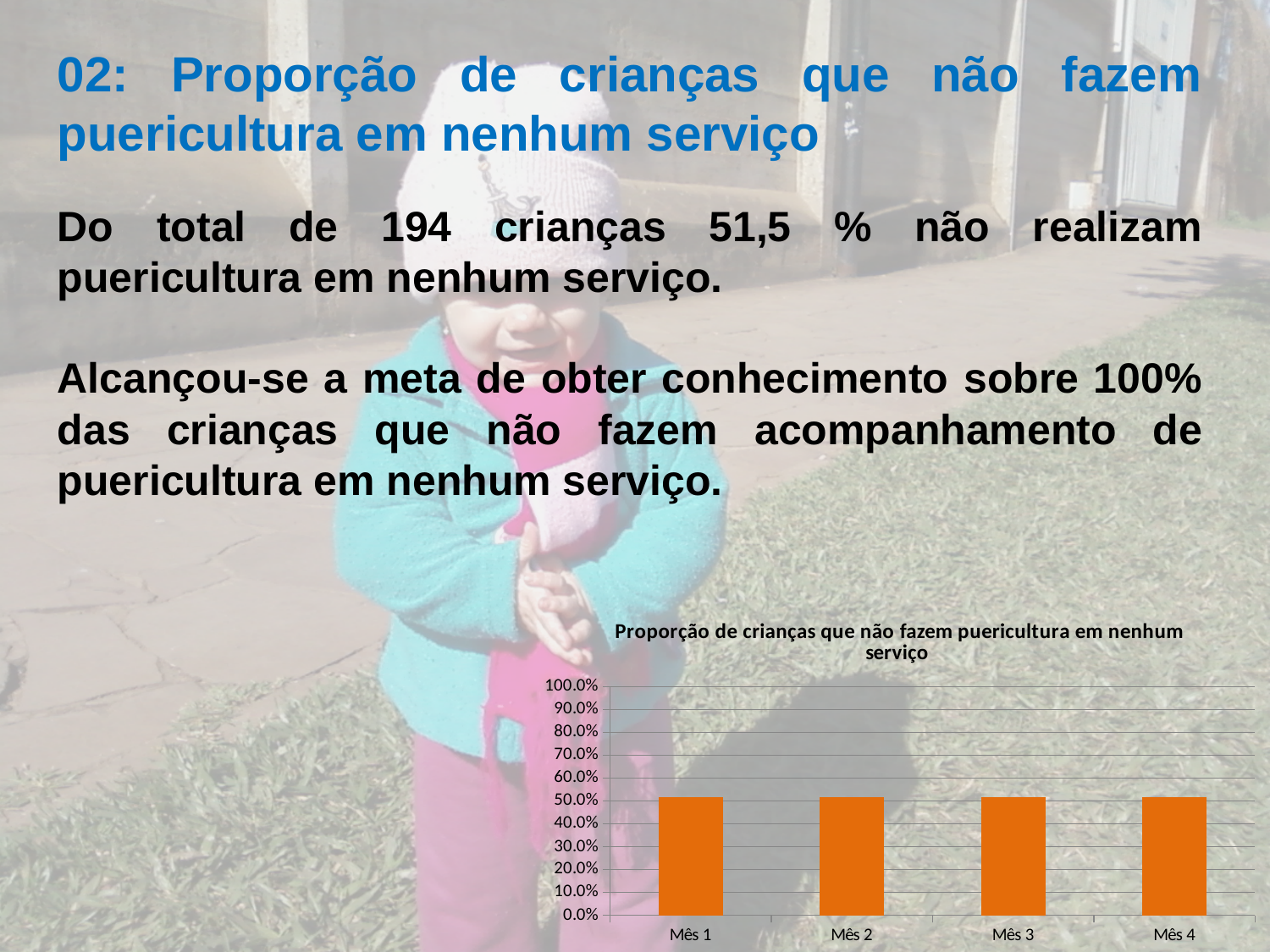
How many categories are shown on the x axis of the chart? 4 Do the values rise, fall, or stay roughly the same from Mês 1 to Mês 4? stay roughly the same What is the highest value shown on the y axis of the chart? 100.0% What kind of chart is shown on the slide? bar chart Is the value for Mês 2 greater or less than 40%? greater Is the value for Mês 4 greater or less than 30%? greater What is the label of the first category on the x axis? Mês 1 What is the title of the chart? Proporção de crianças que não fazem puericultura em nenhum serviço Is the value for Mês 1 greater or less than 60%? less